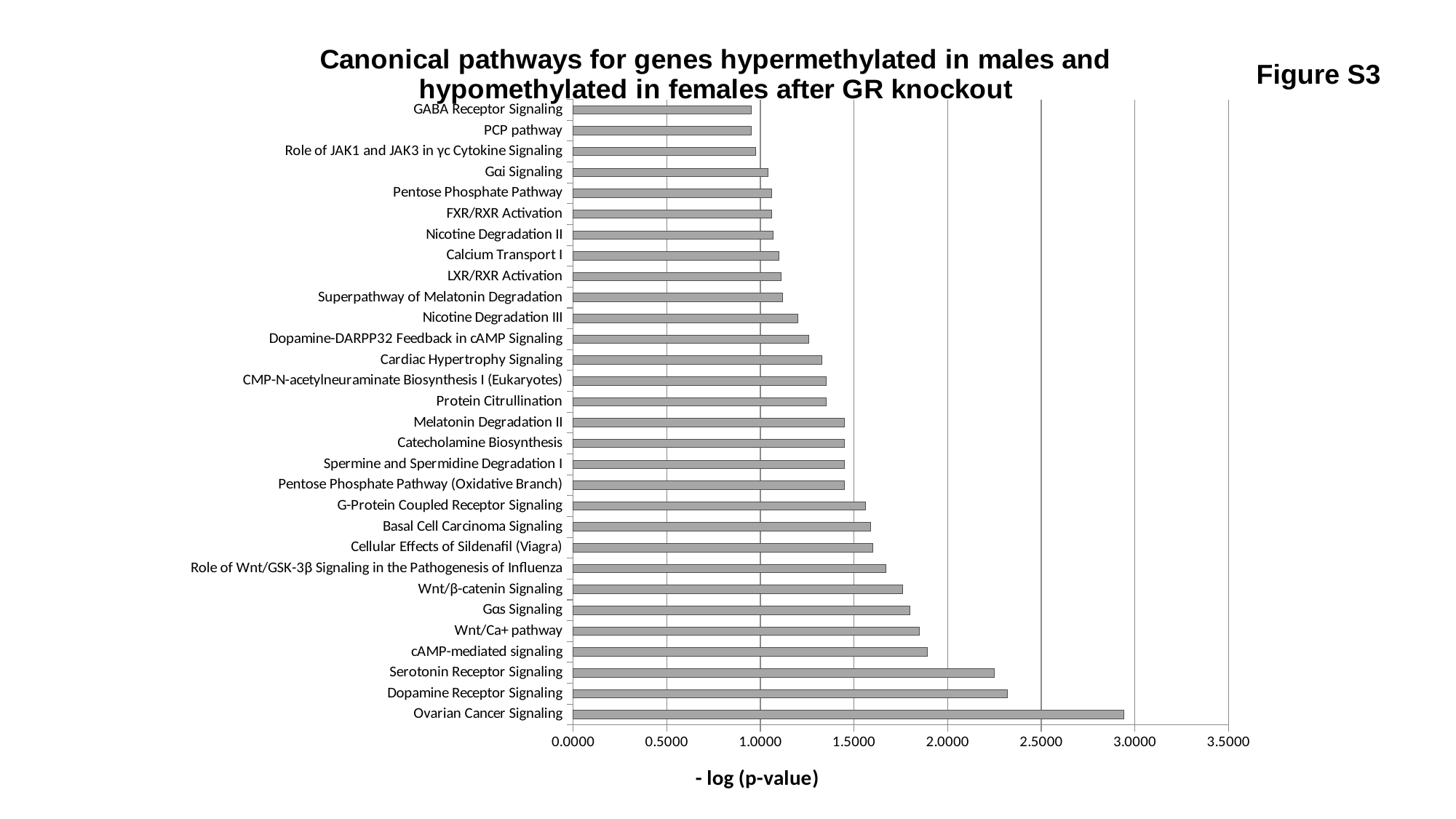
Is the value for cAMP-mediated signaling greater or less than 2.0000? less What is the label of the horizontal axis? - log (p-value) Is the value for Cardiac Hypertrophy Signaling greater or less than 1.5000? less Is the value for Serotonin Receptor Signaling greater or less than 2.0000? greater Which has the larger value, Ovarian Cancer Signaling or Dopamine Receptor Signaling? Ovarian Cancer Signaling Which has the larger value, Gαs Signaling or Gαi Signaling? Gαs Signaling How many pathways are plotted in the chart? 30 Which pathway has the highest - log (p-value)? Ovarian Cancer Signaling What kind of chart is shown on the slide? bar chart